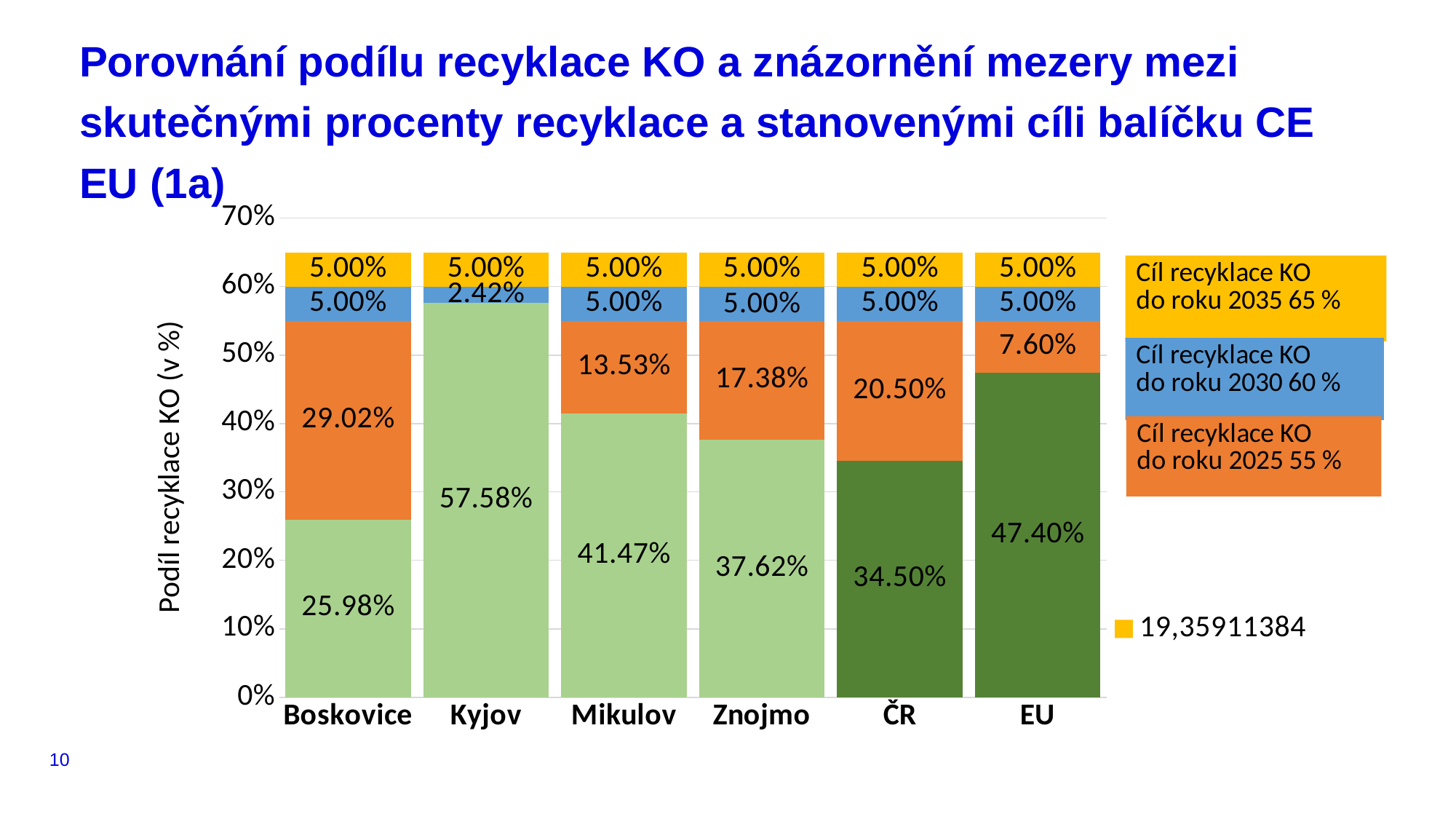
Which category has the lowest bottom (green) segment? Boskovice What is the label of the y axis? Podíl recyklace KO (v %) What is the difference between the green segment values for Mikulov and Znojmo? 3.85% What is the value of the blue segment for Kyjov? 2.42% What is the value of the orange segment for ČR? 20.50% What is the value of the bottom (green) segment for Kyjov? 57.58% What is the total of the stacked bar for Boskovice? 65.00% Which has a larger green segment, EU or ČR? EU How many categories are shown on the x axis? 6 What kind of chart is shown on the slide? Stacked bar chart Which category has the highest bottom (green) segment? Kyjov What is the value of the orange segment for EU? 7.60%